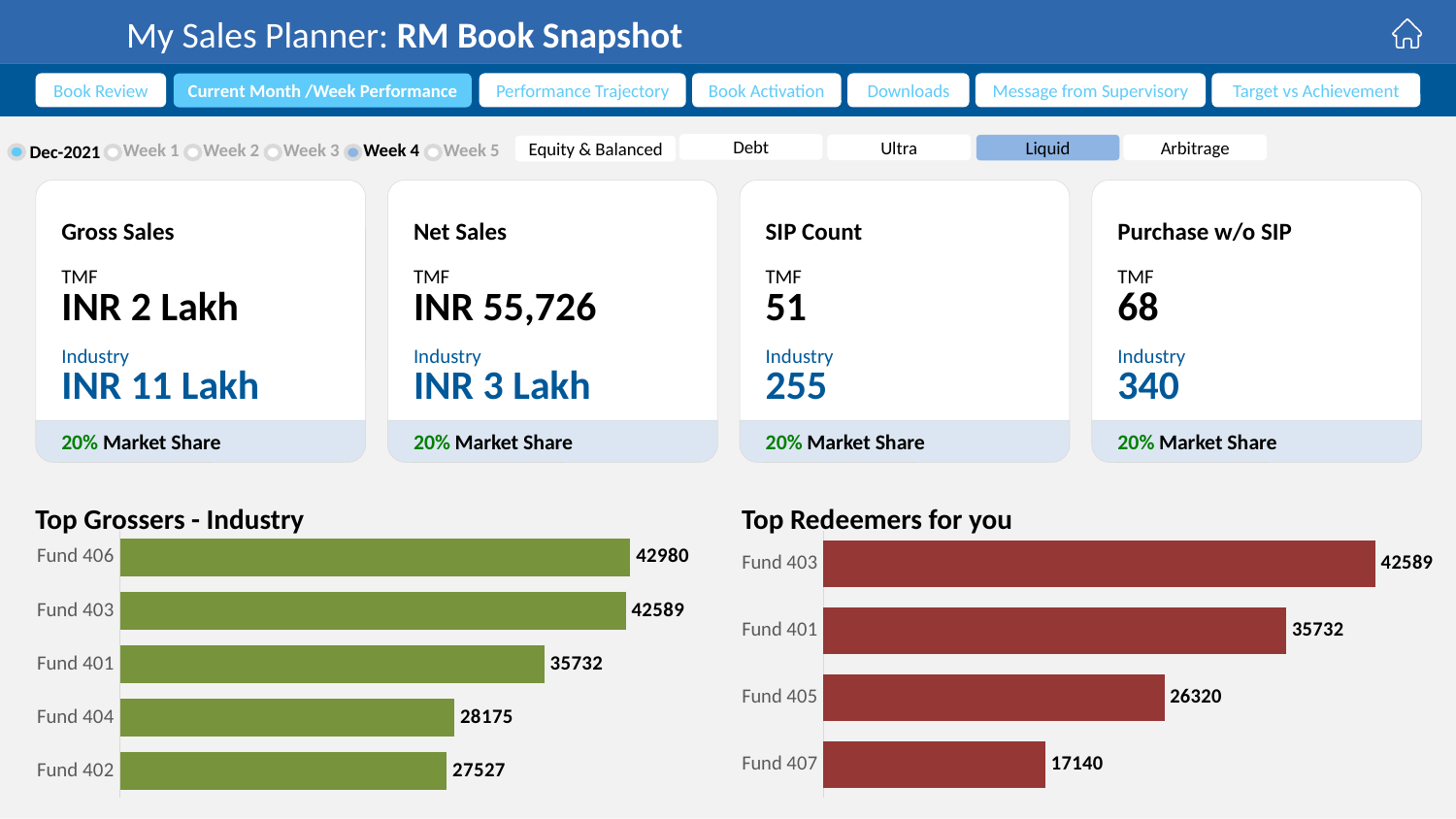
In the 'Top Grossers - Industry' chart, what is the difference between Fund 406 and Fund 403? 391 In the 'Top Redeemers for you' chart, what is the difference between Fund 403 and Fund 401? 6857 In the 'Top Redeemers for you' chart, how many funds are shown? 4 In the 'Top Grossers - Industry' chart, what is the value for Fund 403? 42589 What type of chart is 'Top Grossers - Industry'? Bar chart In the 'Top Grossers - Industry' chart, how many funds are shown? 5 In the 'Top Grossers - Industry' chart, which fund has the lowest value? Fund 402 What colour are the bars in the 'Top Redeemers for you' chart? Red In the 'Top Redeemers for you' chart, which fund has the lowest value? Fund 407 In the 'Top Grossers - Industry' chart, which fund has the highest value? Fund 406 In the 'Top Redeemers for you' chart, which is larger: Fund 401 or Fund 405? Fund 401 In the 'Top Redeemers for you' chart, what is the value for Fund 405? 26320